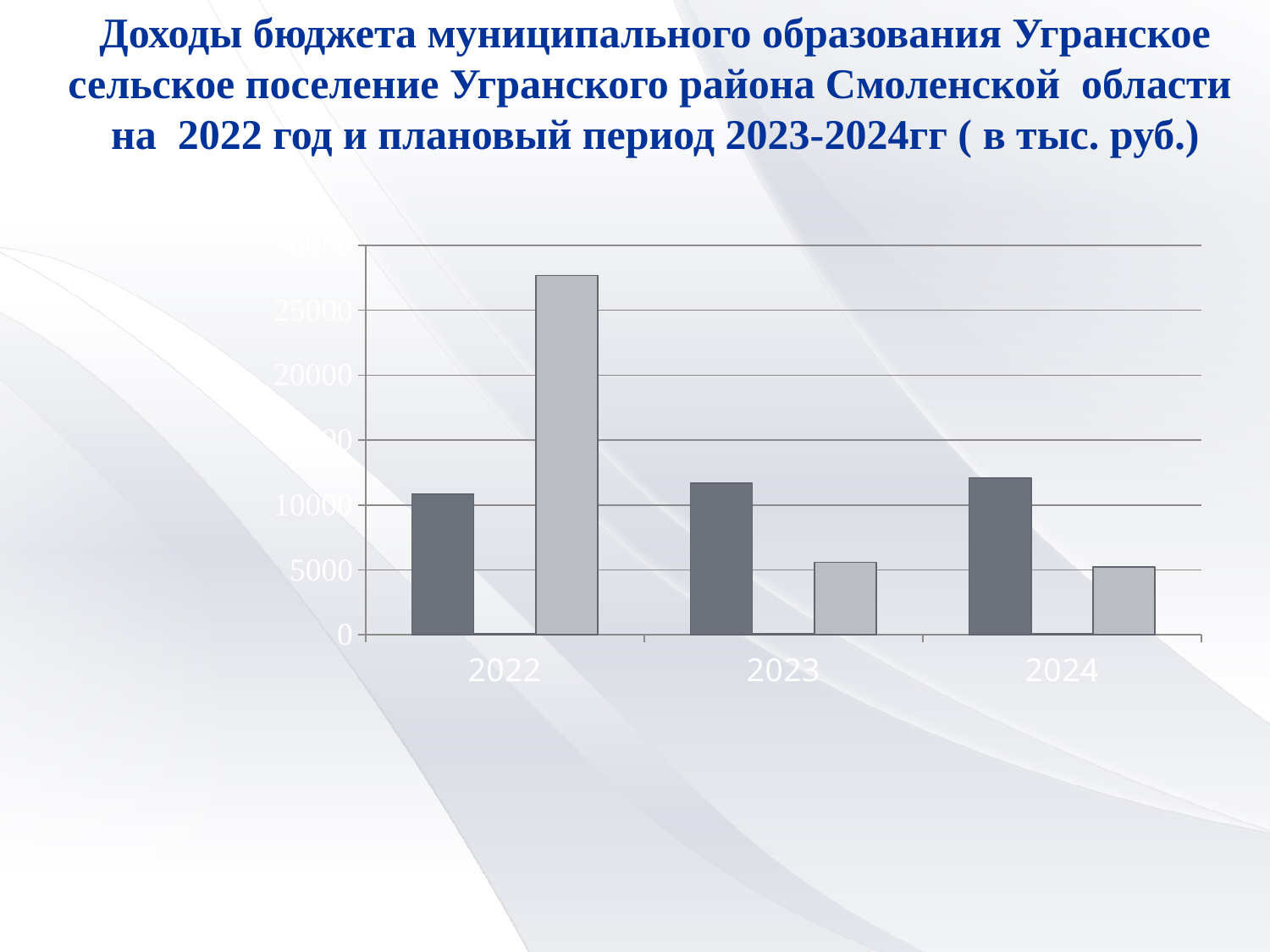
How many years are shown on the x axis of the chart? 3 For 2023, which bar is larger: the dark grey bar or the light grey bar? the dark grey bar What kind of chart is shown on the slide? bar chart Is the value of the dark grey bar for 2022 greater or less than 10000? greater Which year has the tallest bar in the chart? 2022 Do the light grey bars rise or fall from 2022 to 2024? fall Is the value of the light grey bar for 2023 greater or less than 10000? less For 2022, which bar is larger: the dark grey bar or the light grey bar? the light grey bar What is the highest value shown on the y axis of the chart? 30000 Is the value of the dark grey bar for 2024 greater or less than 15000? less